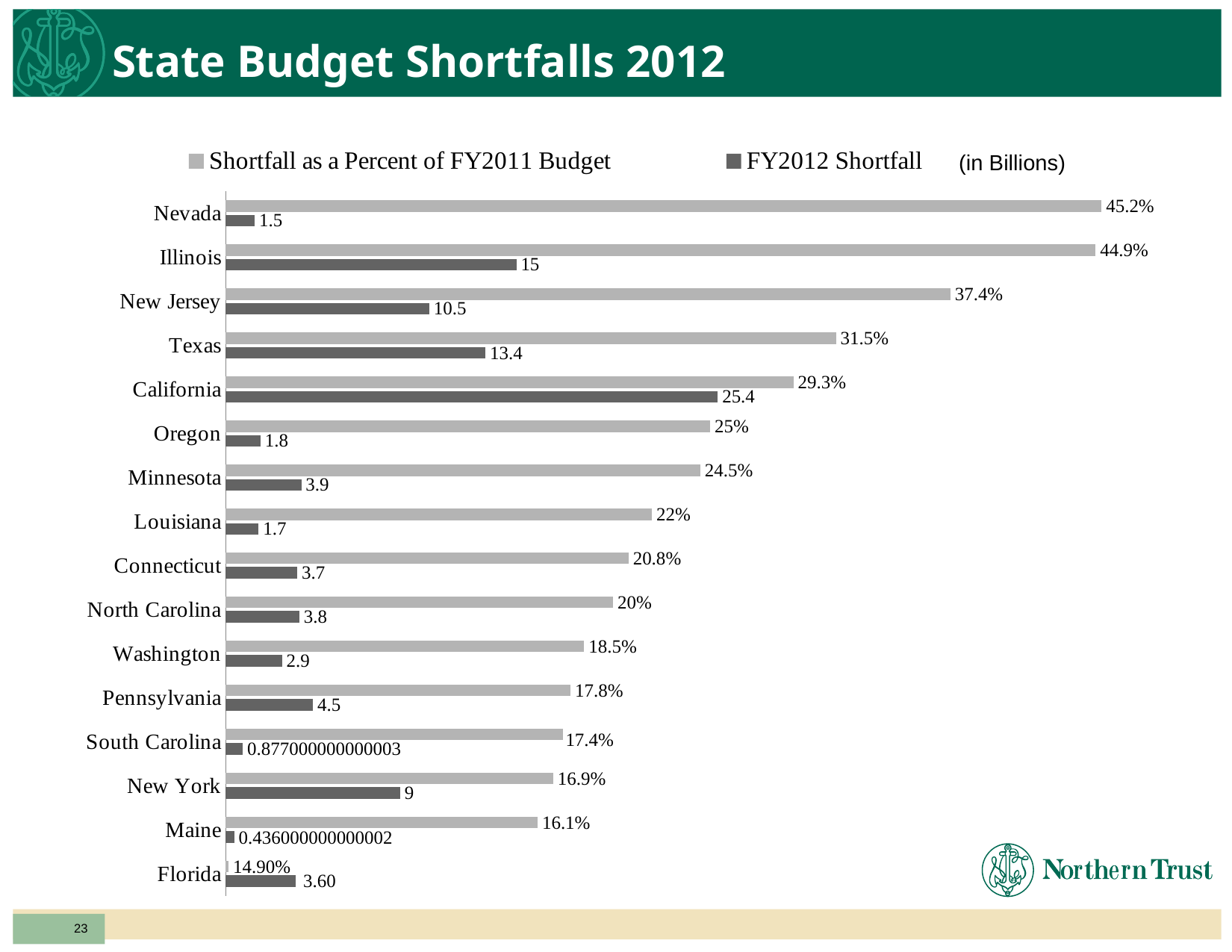
Which state has the highest Shortfall as a Percent of FY2011 Budget? Nevada How many states are shown in the chart? 16 Which is larger, the FY2012 Shortfall for Texas or for Illinois? Illinois What is the FY2012 Shortfall for California? 25.4 What kind of chart is shown on the slide? Bar chart How many series does the legend list? 2 Which state has the highest FY2012 Shortfall? California What is the difference between the FY2012 Shortfall for Illinois and New Jersey? 4.5 What is the Shortfall as a Percent of FY2011 Budget for New Jersey? 37.4% What is the FY2012 Shortfall for Illinois? 15 In what unit is the FY2012 Shortfall series expressed, according to the legend? Billions Which state has the lowest FY2012 Shortfall? Maine